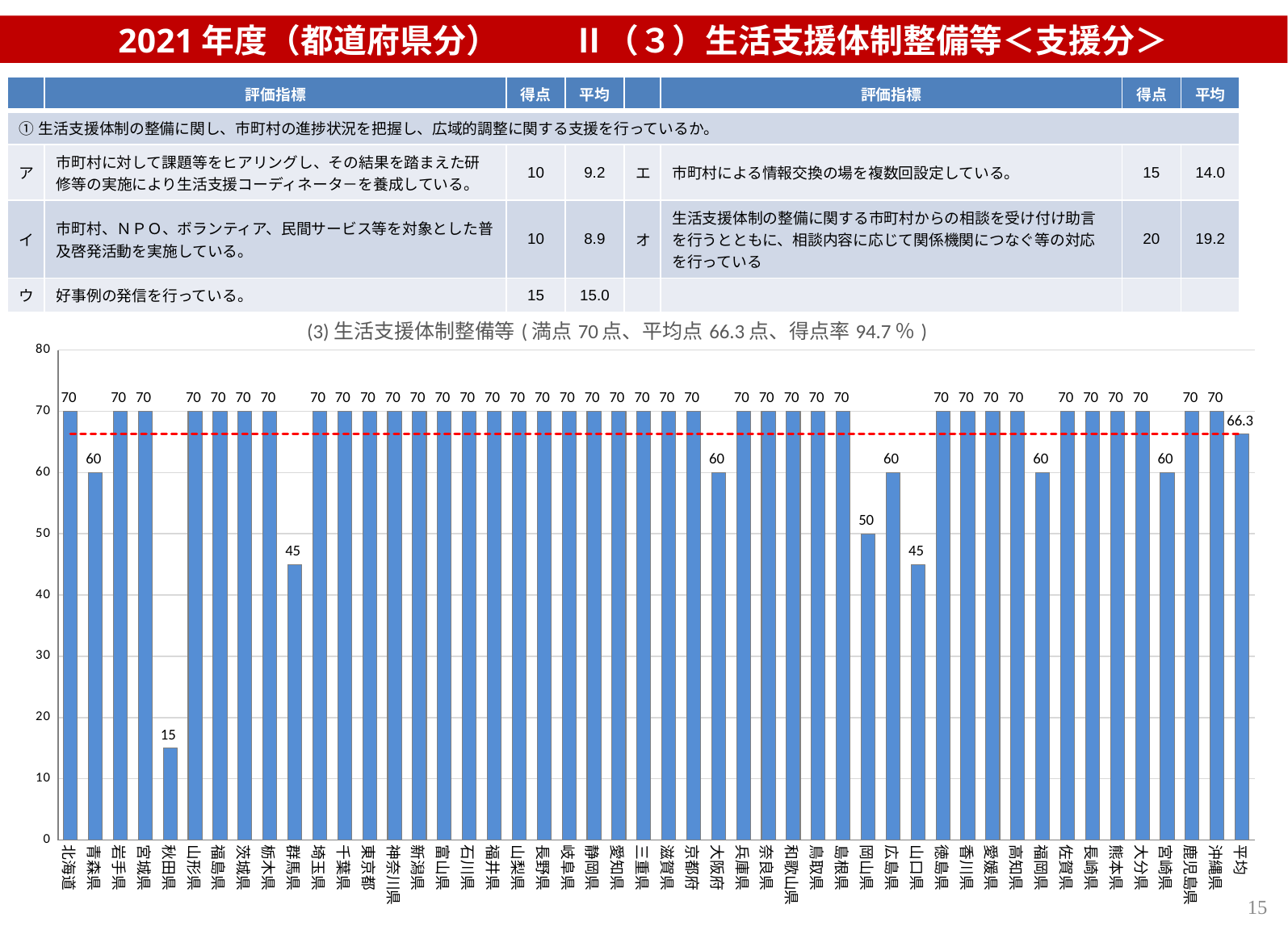
How many bars are plotted in the chart, including 平均? 48 What is the difference between the values for 広島県 and 山口県? 15 What is the value for 岡山県 in the bar chart? 50 What is the value for 群馬県 in the bar chart? 45 What is the difference between the values for 北海道 and 秋田県? 55 What is the value for 秋田県 in the bar chart? 15 Is the value for 青森県 greater or less than 70? less What is the 得点率 stated in the chart title? 94.7％ Which prefecture has the lowest value in the bar chart? 秋田県 What is the value shown for 平均 (the last bar) in the chart? 66.3 Which has the larger value, 岡山県 or 広島県? 広島県 What kind of chart is shown on the slide? bar chart